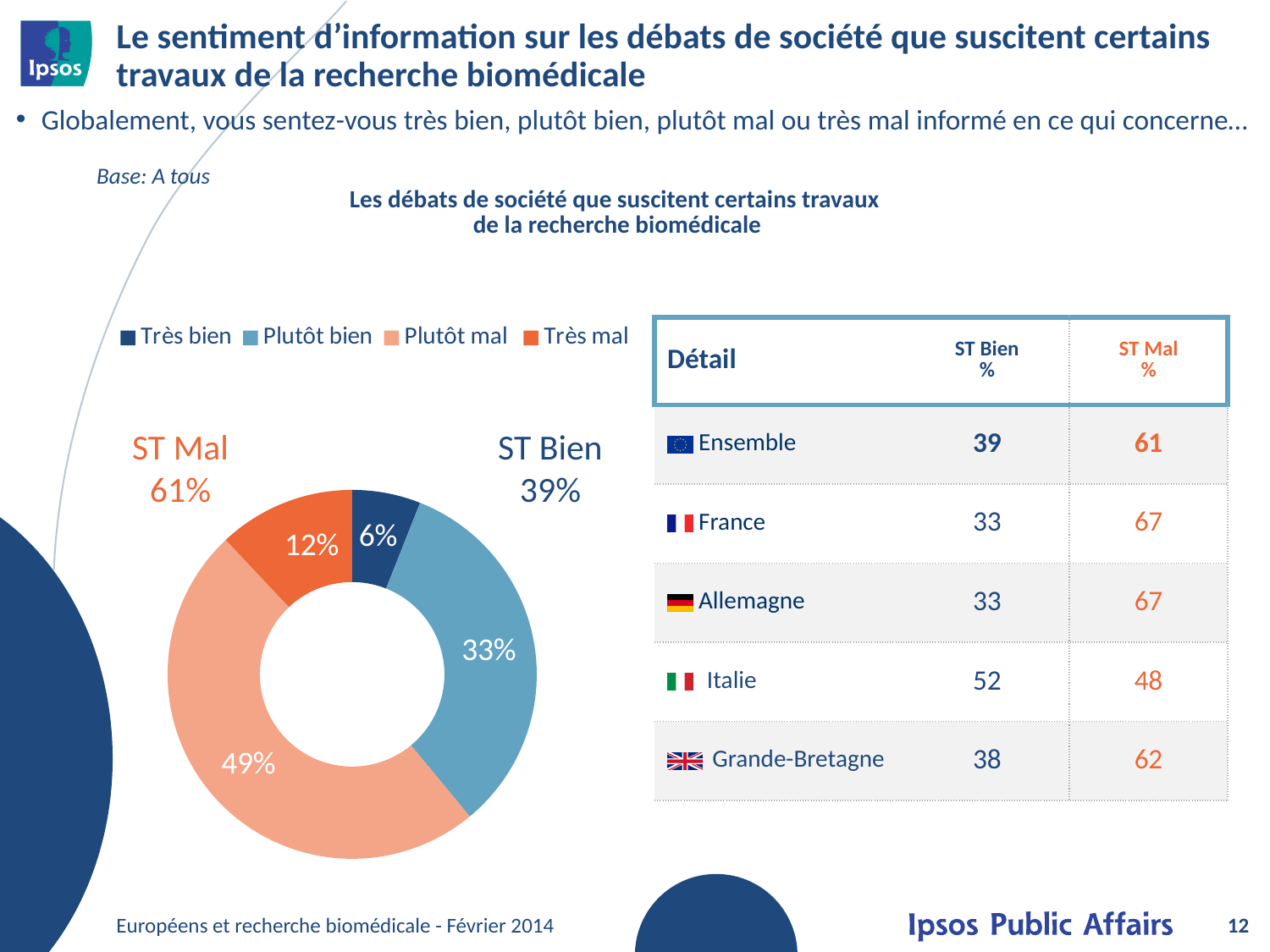
Which category has the largest share in the donut chart? Plutôt mal What is the combined share labelled "ST Mal" next to the donut chart? 61% What is the difference between the "Plutôt mal" and "Plutôt bien" shares in the donut chart? 16% Which is larger in the donut chart, "Très mal" or "Très bien"? Très mal What is the value for "Plutôt bien" in the donut chart? 33% How many categories does the legend of the donut chart list? 4 What is the combined share labelled "ST Bien" next to the donut chart? 39% What is the value for "Très bien" in the donut chart? 6% Which category has the smallest share in the donut chart? Très bien What is the value for "Très mal" in the donut chart? 12% What kind of chart is shown on the slide? Pie chart (donut) What is the value for "Plutôt mal" in the donut chart? 49%